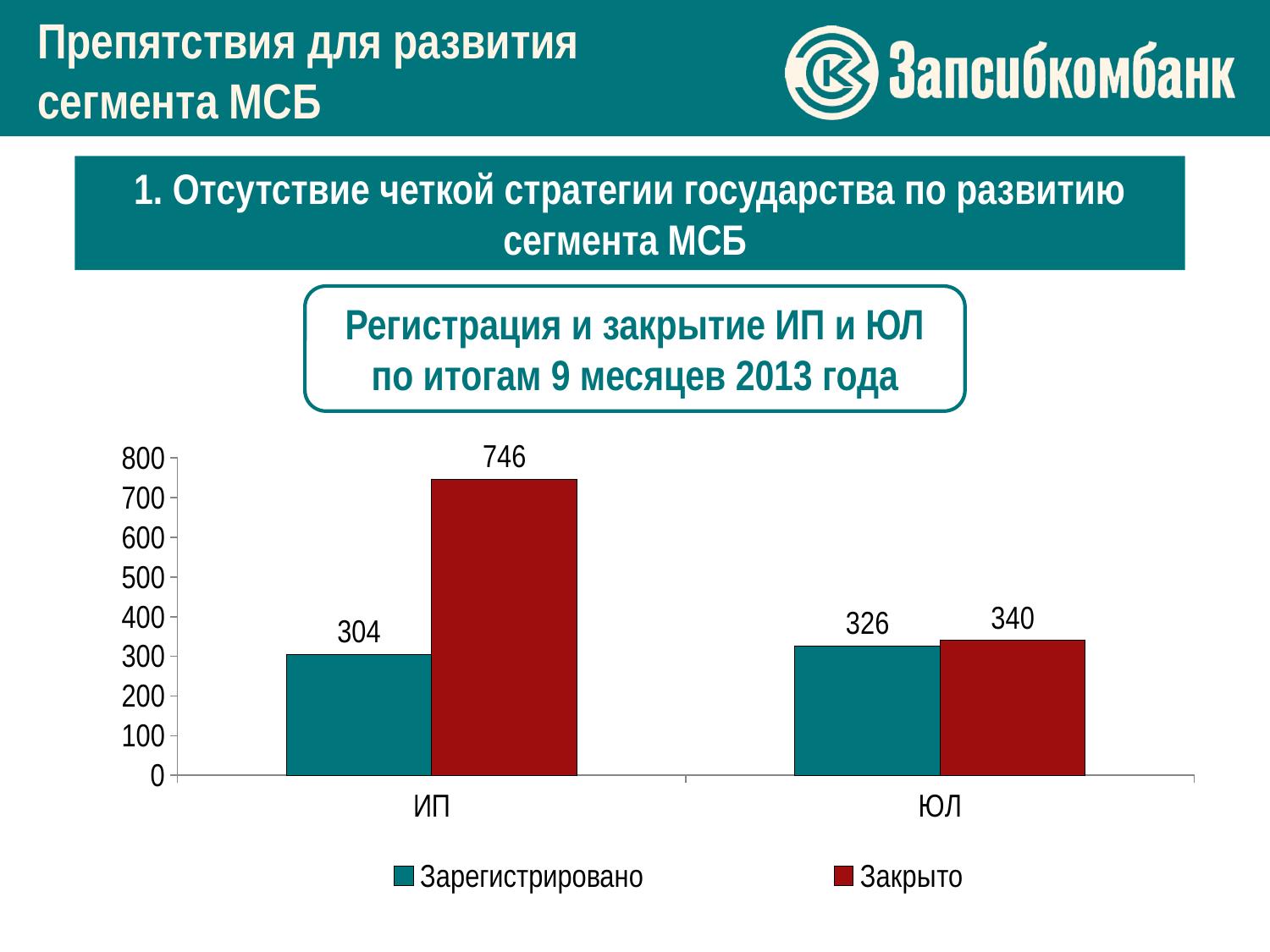
What is the value of Закрыто for ЮЛ? 340 What is the value of Зарегистрировано for ИП? 304 What kind of chart is shown on the slide? bar chart Which category has the highest Закрыто value? ИП What is the difference between Закрыто and Зарегистрировано for ЮЛ? 14 How many categories are shown on the x axis? 2 Which category has the lowest Зарегистрировано value? ИП Which is larger: Закрыто for ИП or Закрыто for ЮЛ? Закрыто for ИП How many series does the legend list? 2 What is the value of Зарегистрировано for ЮЛ? 326 What is the difference between Закрыто and Зарегистрировано for ИП? 442 What is the value of Закрыто for ИП? 746